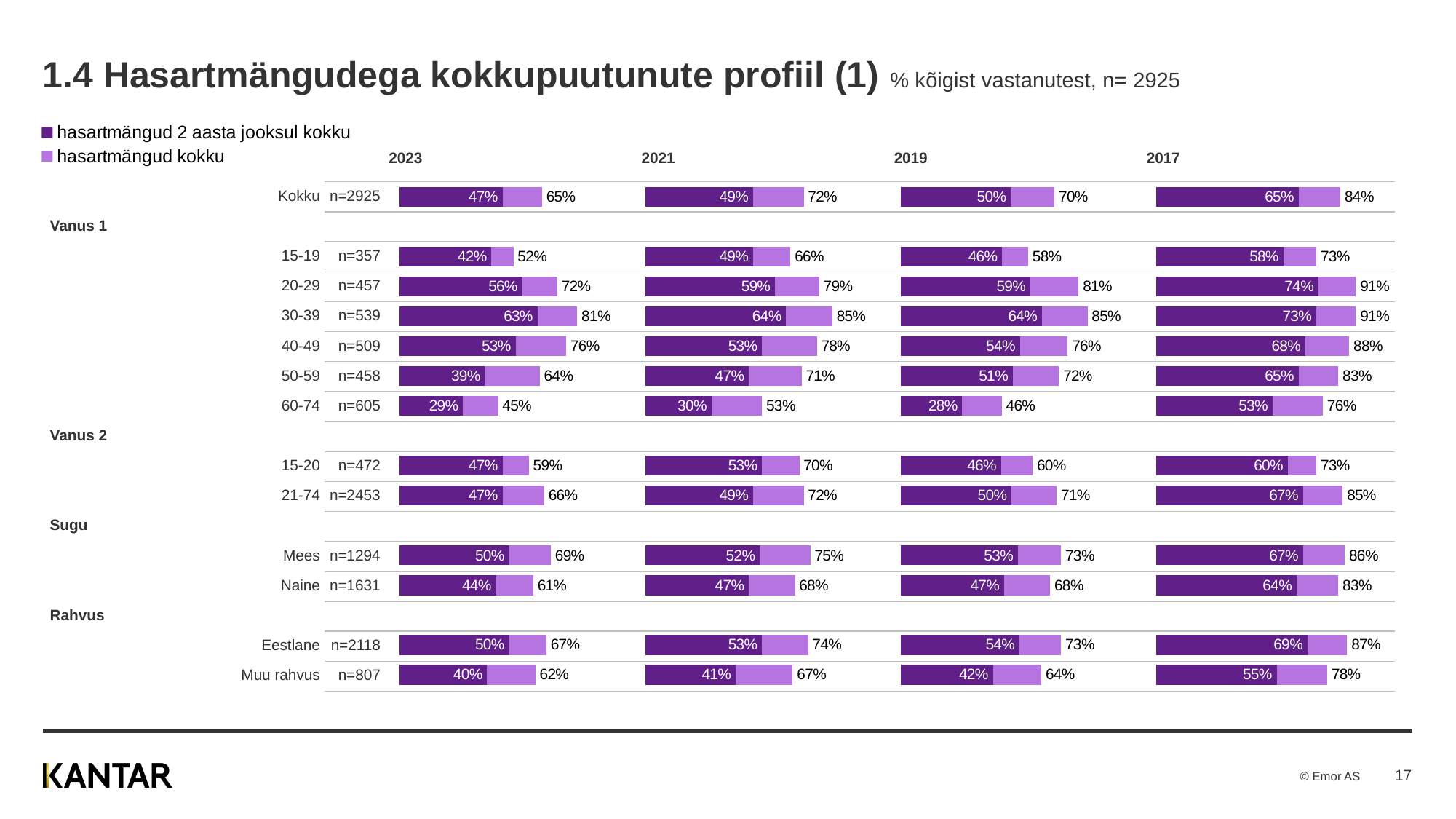
In the 2023 chart, which Vanus 1 age group has the highest value for 'hasartmängud 2 aasta jooksul kokku'? 30-39 In the 2021 chart, which is larger for 'hasartmängud 2 aasta jooksul kokku': Eestlane or Muu rahvus? Eestlane How many year charts are shown on the slide? 4 In the 2019 chart, what is the value of 'hasartmängud kokku' for Muu rahvus? 64% What kind of chart is used on this slide? Bar chart In the 2023 chart, what is the value of 'hasartmängud 2 aasta jooksul kokku' for Kokku? 47% How many series does the legend list? 2 In the 2023 chart, what is the difference between the 'hasartmängud kokku' values for Mees and Naine? 8 percentage points In the 2017 chart, what is the value of 'hasartmängud kokku' for the 20-29 age group? 91% What is the sample size (n) shown for the 60-74 age group? n=605 In the 2021 chart, what is the value of 'hasartmängud 2 aasta jooksul kokku' for Naine? 47% In the 2017 chart, which Vanus 1 age group has the lowest value for 'hasartmängud kokku'? 15-19